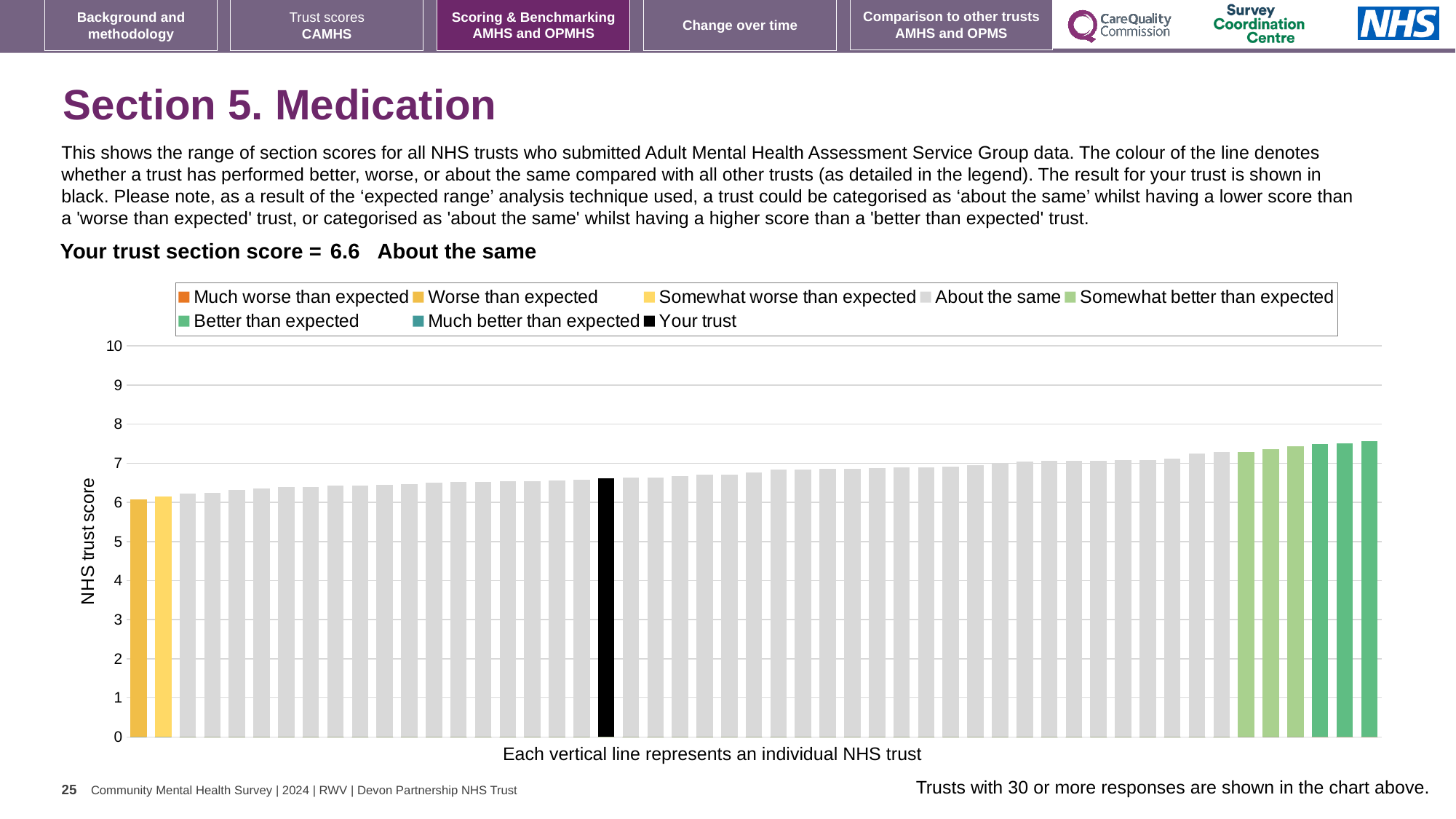
Which legend category does the tallest bar belong to? Better than expected What kind of chart is shown on the slide? bar chart Do the bar values rise or fall from left to right across the chart? rise How many bars are coloured as 'Worse than expected'? 1 Which category is your trust placed in for this section? About the same How many entries does the chart legend list? 8 Is the value for your trust (the black bar) greater or less than 5? greater What is the section score for your trust shown on the slide? 6.6 What is the label on the vertical axis of the chart? NHS trust score Which legend category does the shortest bar belong to? Worse than expected Is the value of the shortest bar in the chart greater or less than 5? greater Is the value of the tallest bar in the chart greater or less than 8? less